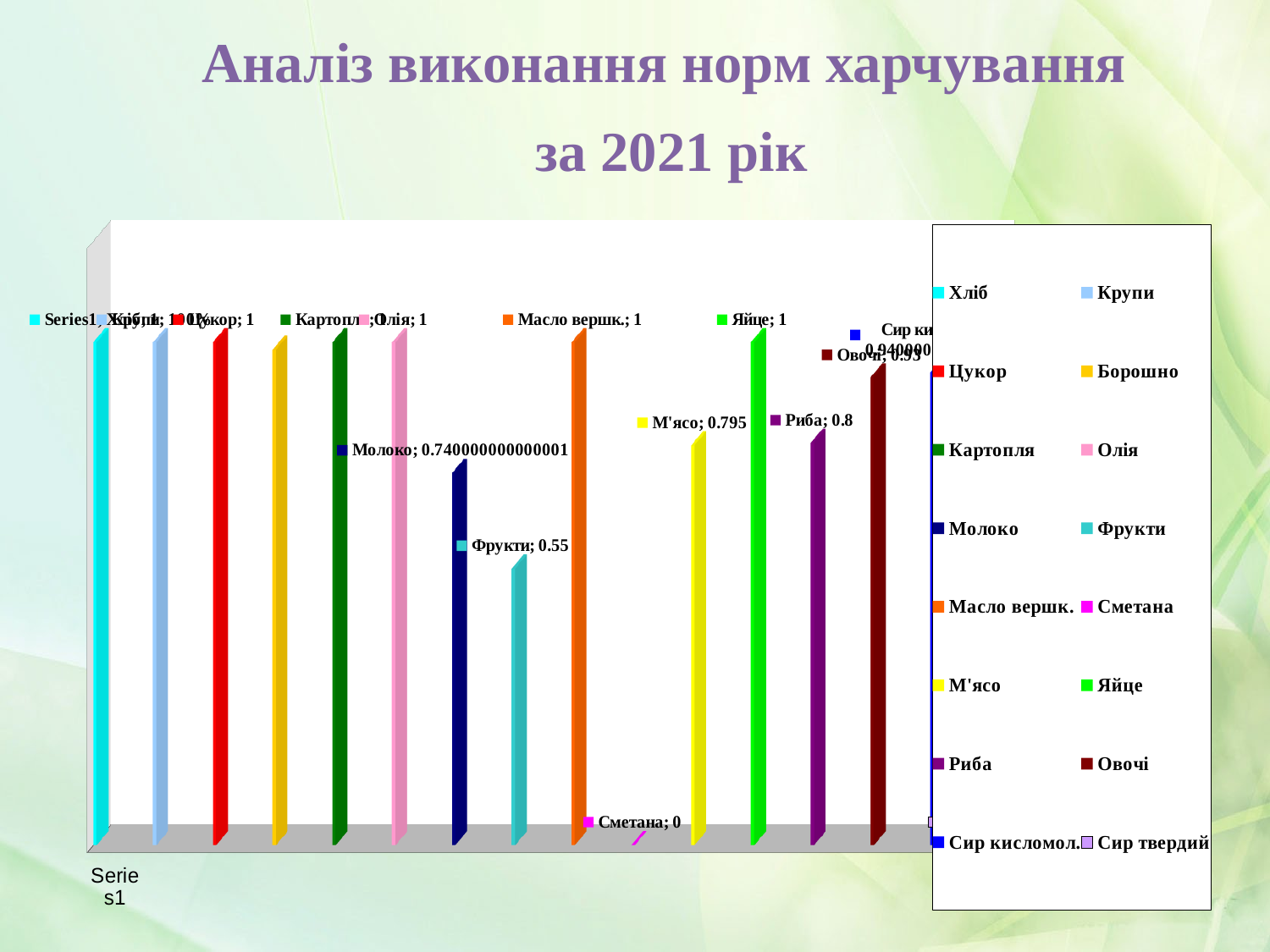
Which series has the lowest value? Сметана What is the value for М'ясо? 0.795 What kind of chart is shown on the slide? bar chart How many series does the legend list? 16 What is the value for Яйце? 1 What is the value for Фрукти? 0.55 What is the difference between the value for Риба and the value for Фрукти? 0.25 What is the value for Масло вершк.? 1 What is the value for Риба? 0.8 Which is larger, the value for Риба or the value for Фрукти? Риба What is the value for Сметана? 0 What is the title of the slide? Аналіз виконання норм харчування за 2021 рік